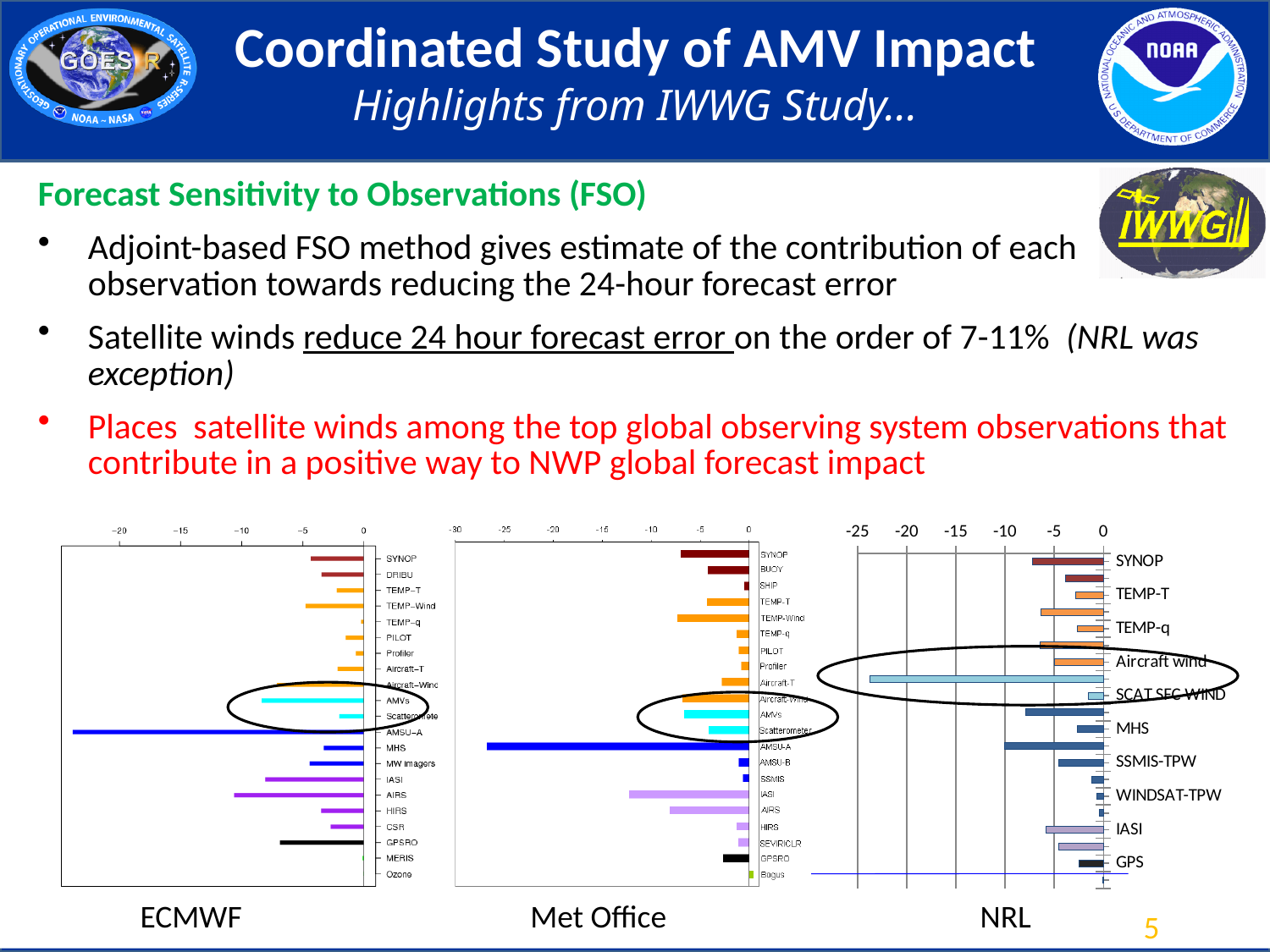
How many charts are shown on the slide? 3 What is the leftmost axis tick value shown on the Met Office chart? -30 What kind of chart is the ECMWF chart? bar chart In the ECMWF chart, is the value for AMVs greater or less than -5? less In the ECMWF chart, is the value for AMSU-A greater or less than -20? less In the NRL chart, which has the longer bar, SYNOP or TEMP-T? SYNOP In the ECMWF chart, which has the longer bar, AMVs or Scatterometer? AMVs In the ECMWF chart, which category has the longest bar (most negative value)? AMSU-A In the Met Office chart, which category has the longest bar (most negative value)? AMSU-A In the Met Office chart, is the value for AMVs greater or less than -5? less